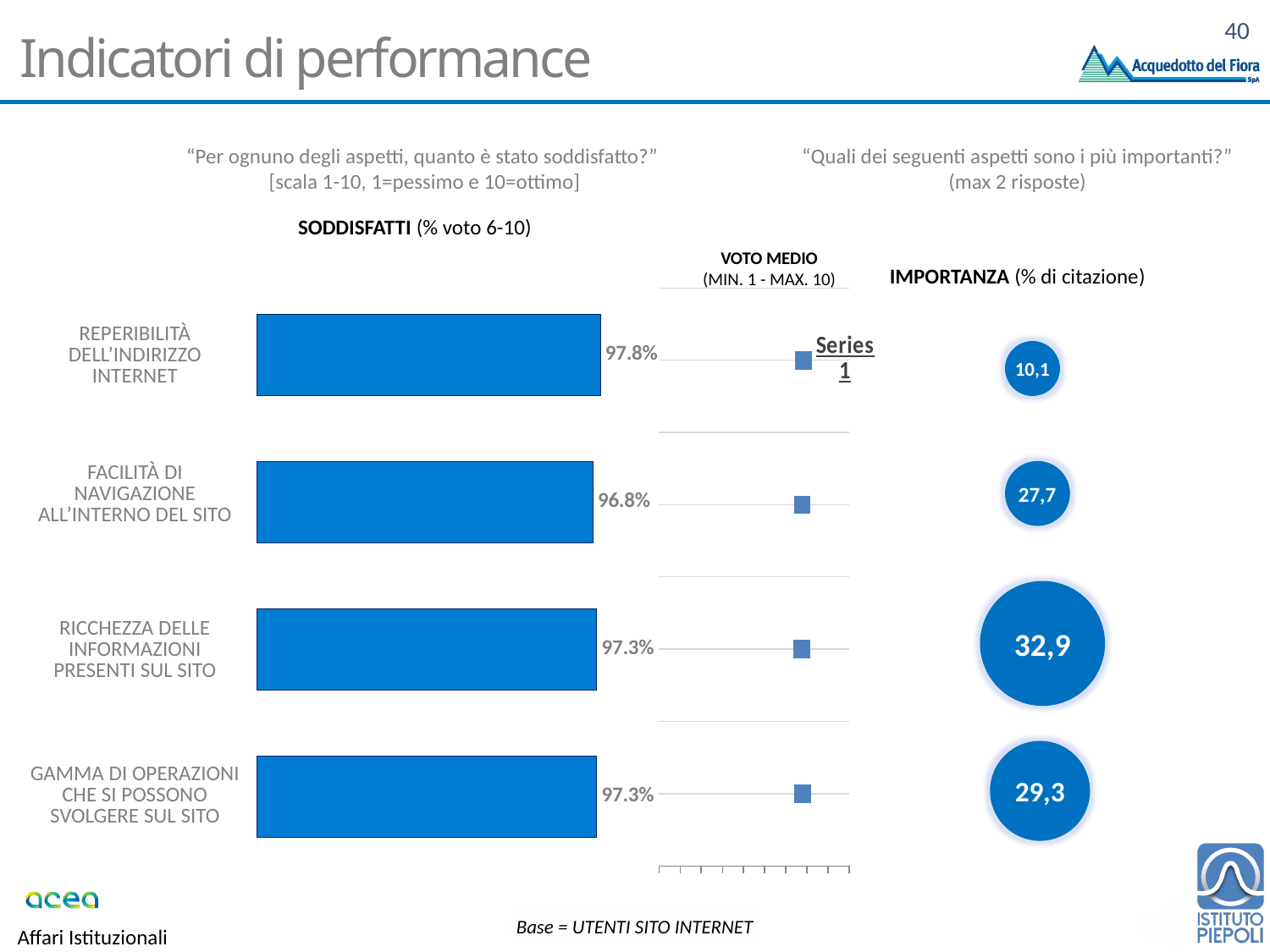
In the IMPORTANZA (% di citazione) chart, which category has the highest value? RICCHEZZA DELLE INFORMAZIONI PRESENTI SUL SITO In the SODDISFATTI chart, what is the value for REPERIBILITÀ DELL'INDIRIZZO INTERNET? 97.8% In the SODDISFATTI chart, how many categories are shown? 4 In the SODDISFATTI chart, which category has the lowest value? FACILITÀ DI NAVIGAZIONE ALL'INTERNO DEL SITO In the IMPORTANZA (% di citazione) chart, what is the value for RICCHEZZA DELLE INFORMAZIONI PRESENTI SUL SITO? 32,9 In the IMPORTANZA (% di citazione) chart, which is larger: the value for FACILITÀ DI NAVIGAZIONE ALL'INTERNO DEL SITO or GAMMA DI OPERAZIONI CHE SI POSSONO SVOLGERE SUL SITO? GAMMA DI OPERAZIONI CHE SI POSSONO SVOLGERE SUL SITO In the SODDISFATTI chart, which category has the highest value? REPERIBILITÀ DELL'INDIRIZZO INTERNET In the IMPORTANZA (% di citazione) chart, what is the value for REPERIBILITÀ DELL'INDIRIZZO INTERNET? 10,1 In the SODDISFATTI chart, what is the value for FACILITÀ DI NAVIGAZIONE ALL'INTERNO DEL SITO? 96.8% What kind of chart is the SODDISFATTI chart? Bar chart In the SODDISFATTI chart, what is the difference between the values for REPERIBILITÀ DELL'INDIRIZZO INTERNET and FACILITÀ DI NAVIGAZIONE ALL'INTERNO DEL SITO? 1.0% In the SODDISFATTI chart, what is the value for GAMMA DI OPERAZIONI CHE SI POSSONO SVOLGERE SUL SITO? 97.3%